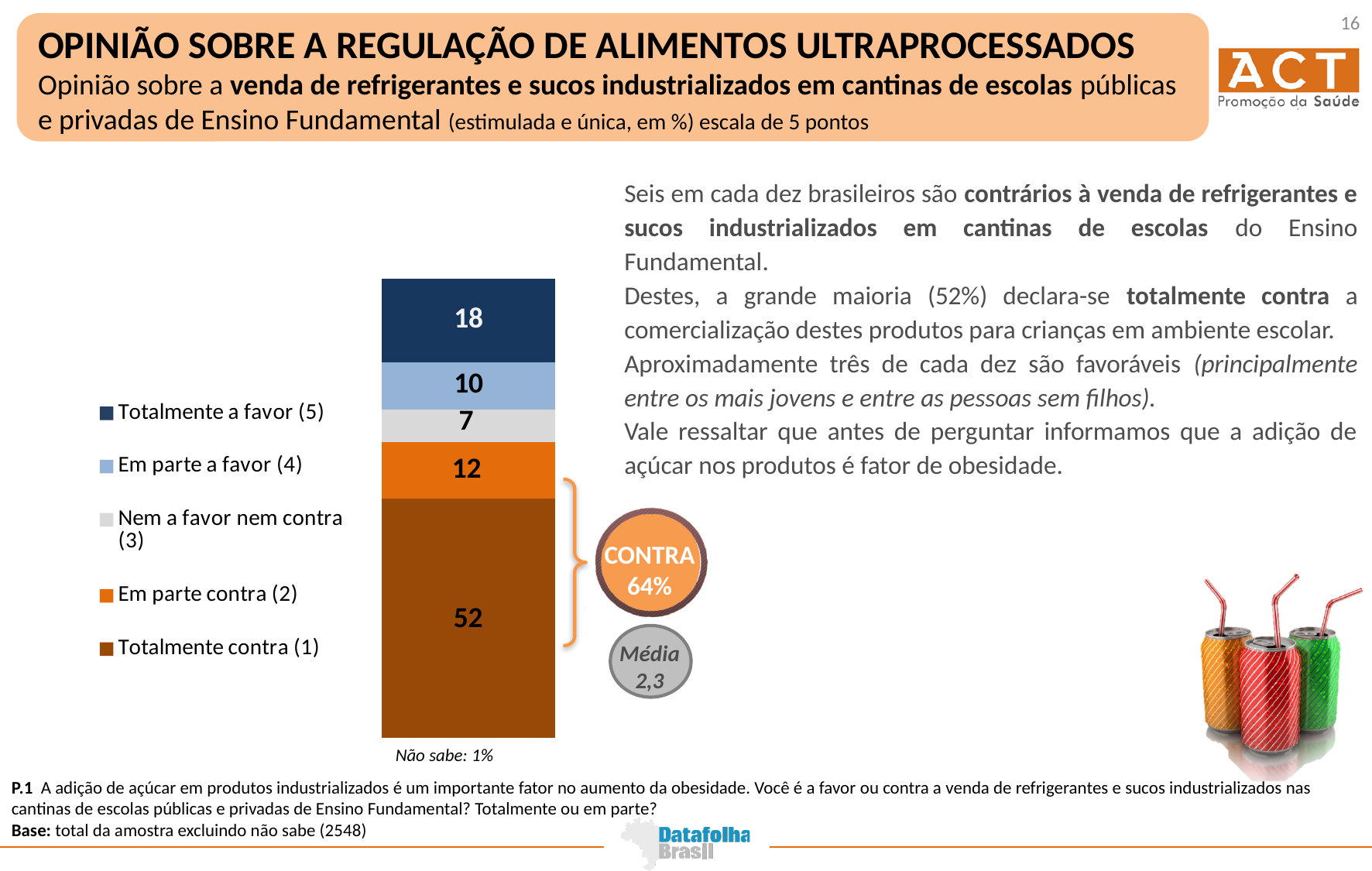
What is the difference between the values for "Totalmente contra (1)" and "Em parte contra (2)"? 40 Which segment of the stacked bar has the largest value? Totalmente contra (1) What value is shown for "Totalmente contra (1)" in the stacked bar? 52 What percentage is shown in the "CONTRA" circle next to the bar? 64% What value is shown for "Em parte a favor (4)"? 10 How many series does the legend list? 5 Which is larger: the value for "Totalmente a favor (5)" or "Em parte a favor (4)"? Totalmente a favor (5) What value is shown for "Totalmente a favor (5)" in the stacked bar? 18 What kind of chart is shown on the slide? Stacked bar chart Which segment of the stacked bar has the smallest value? Nem a favor nem contra (3) What value is shown for "Nem a favor nem contra (3)"? 7 What is the sum of the two "contra" segments (Totalmente contra and Em parte contra)? 64